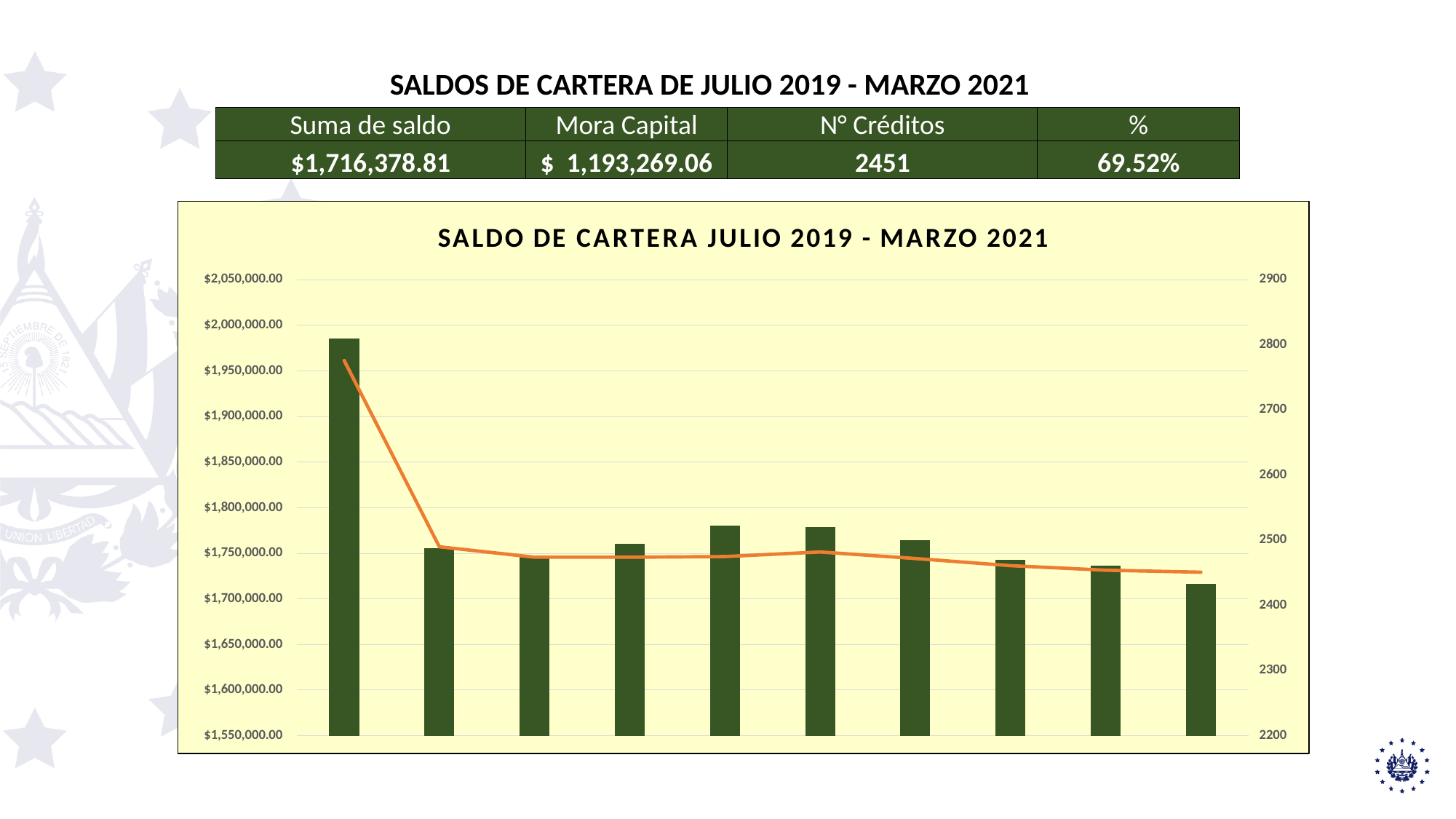
Is the value of the last (rightmost) bar greater or less than $1,750,000.00 on the left axis? less Is the value of the first (leftmost) bar greater or less than $1,950,000.00 on the left axis? greater Which bar is the shortest in the chart? The last (rightmost) bar Which bar is the tallest in the chart? The first (leftmost) bar What is the highest value shown on the left vertical axis? $2,050,000.00 Overall, do the bar values rise or fall from left to right across the chart? Fall How many bars are plotted in the chart? 10 Is the value of the fifth bar from the left greater or less than $1,800,000.00 on the left axis? less Which is larger, the first bar or the second bar? The first bar What is the title of the chart on the slide? SALDO DE CARTERA JULIO 2019 - MARZO 2021 What kind of chart is shown on the slide? A combined bar and line chart